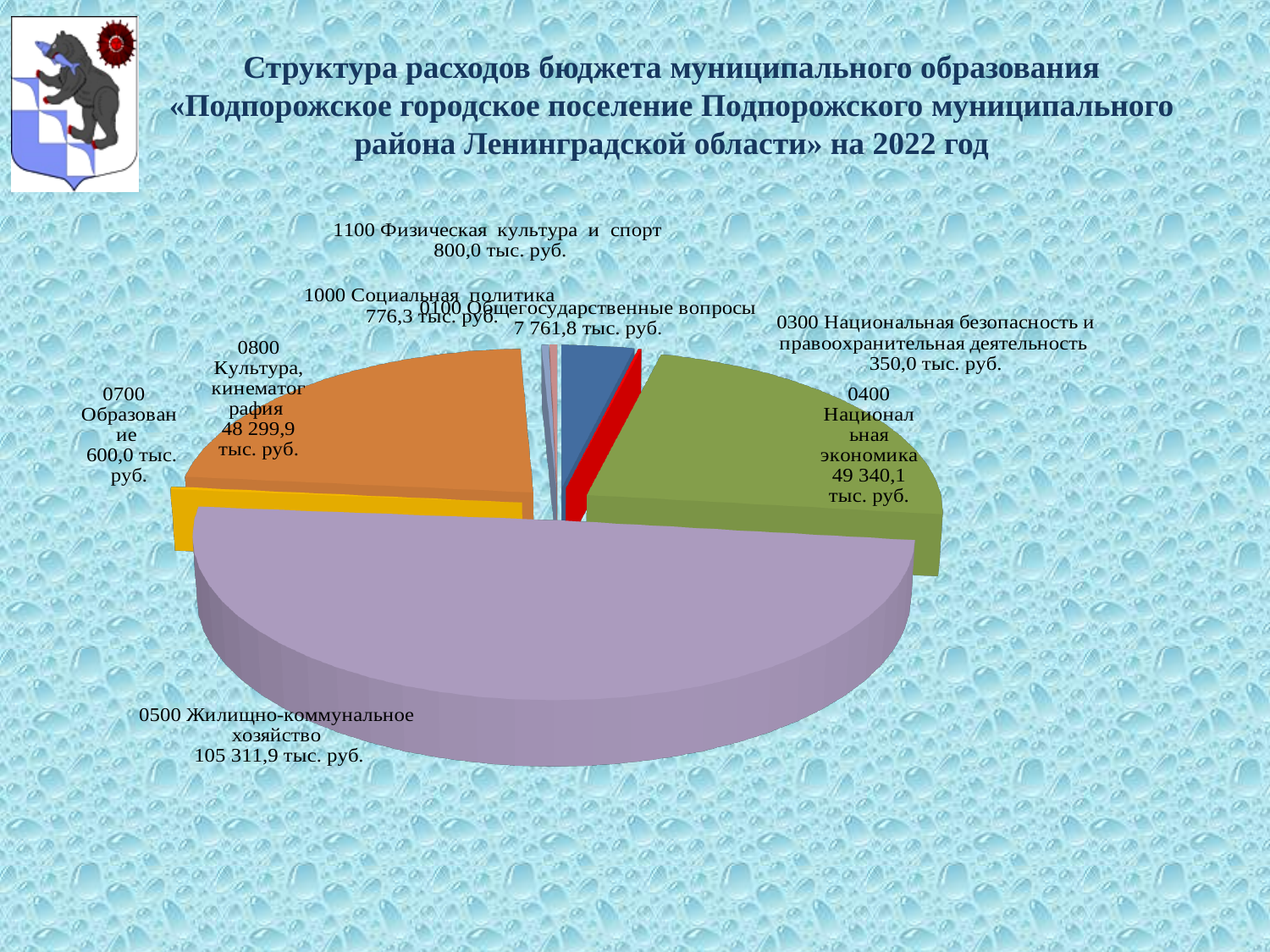
Which category has the smallest value? 0300 Национальная безопасность и правоохранительная деятельность What is the value for 1000 Социальная политика? 776,3 тыс. руб. What is the value for 0500 Жилищно-коммунальное хозяйство? 105 311,9 тыс. руб. What kind of chart is shown on the slide? Pie chart What is the value for 0800 Культура, кинематография? 48 299,9 тыс. руб. What year does the chart title say the budget expenditure structure refers to? 2022 Which category has the largest share of the budget expenditures? 0500 Жилищно-коммунальное хозяйство What is the value for 0100 Общегосударственные вопросы? 7 761,8 тыс. руб. What is the difference between 1100 Физическая культура и спорт and 0700 Образование? 200,0 тыс. руб. What is the value for 0400 Национальная экономика? 49 340,1 тыс. руб. How many categories (slices) does the pie chart show? 8 Which is larger: 0400 Национальная экономика or 0800 Культура, кинематография? 0400 Национальная экономика